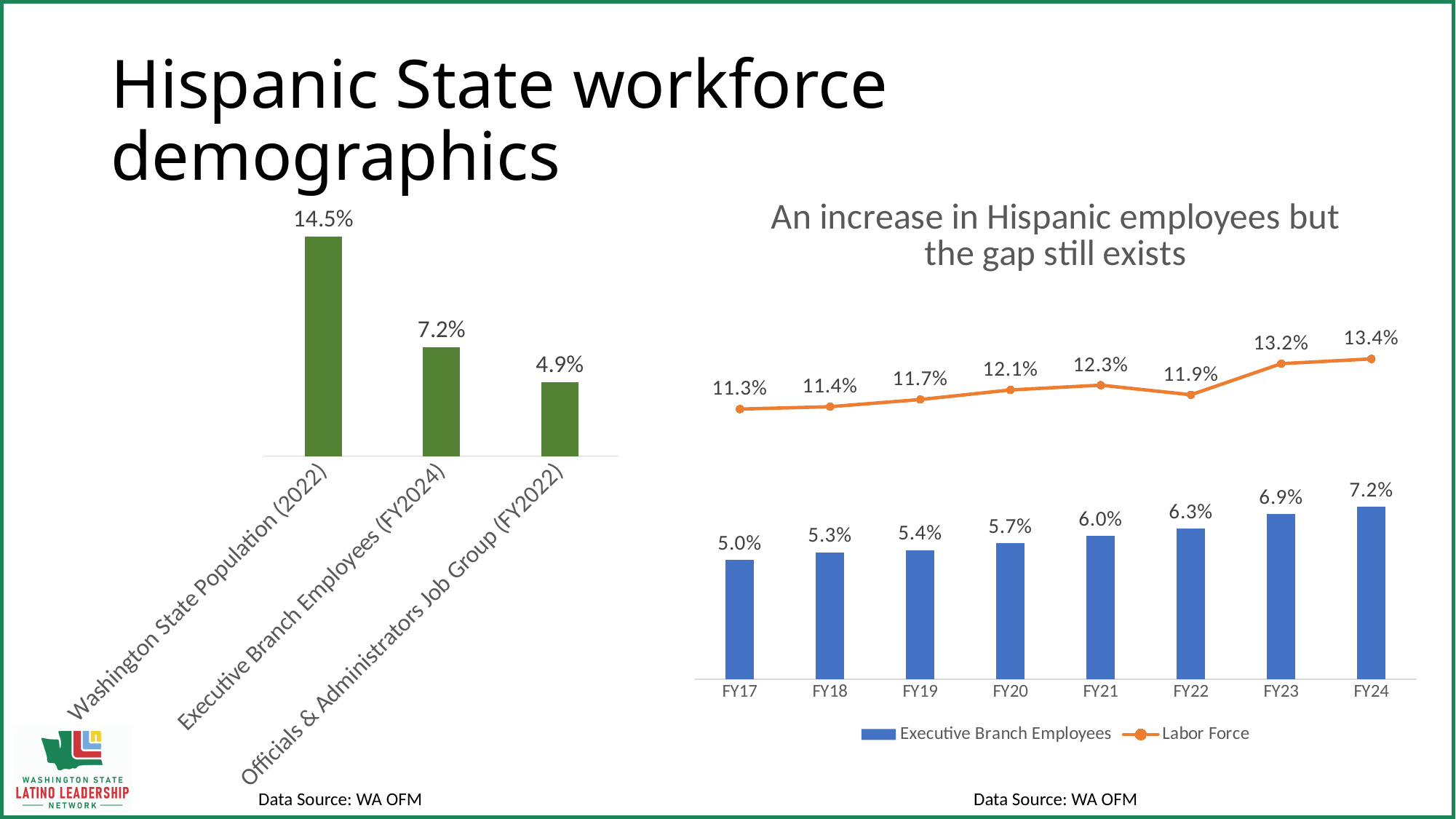
How many series does the legend of the right chart list? 2 In the chart titled 'An increase in Hispanic employees but the gap still exists', what is the difference between the Labor Force and Executive Branch Employees values in FY24? 6.2% In the chart titled 'An increase in Hispanic employees but the gap still exists', is the Labor Force value higher in FY21 or FY22? FY21 How many bars are in the left chart? 3 In the chart titled 'An increase in Hispanic employees but the gap still exists', what is the Executive Branch Employees value for FY20? 5.7% In the left chart, which category has the lowest value? Officials & Administrators Job Group (FY2022) What type of chart is the left chart? bar chart In the chart titled 'An increase in Hispanic employees but the gap still exists', what is the Labor Force value for FY22? 11.9% In the chart titled 'An increase in Hispanic employees but the gap still exists', do the Executive Branch Employees values rise or fall from FY17 to FY24? rise In the left chart, what is the value for Washington State Population (2022)? 14.5% In the chart titled 'An increase in Hispanic employees but the gap still exists', which fiscal year has the highest Executive Branch Employees value? FY24 In the left chart, what is the difference between Washington State Population (2022) and Executive Branch Employees (FY2024)? 7.3%